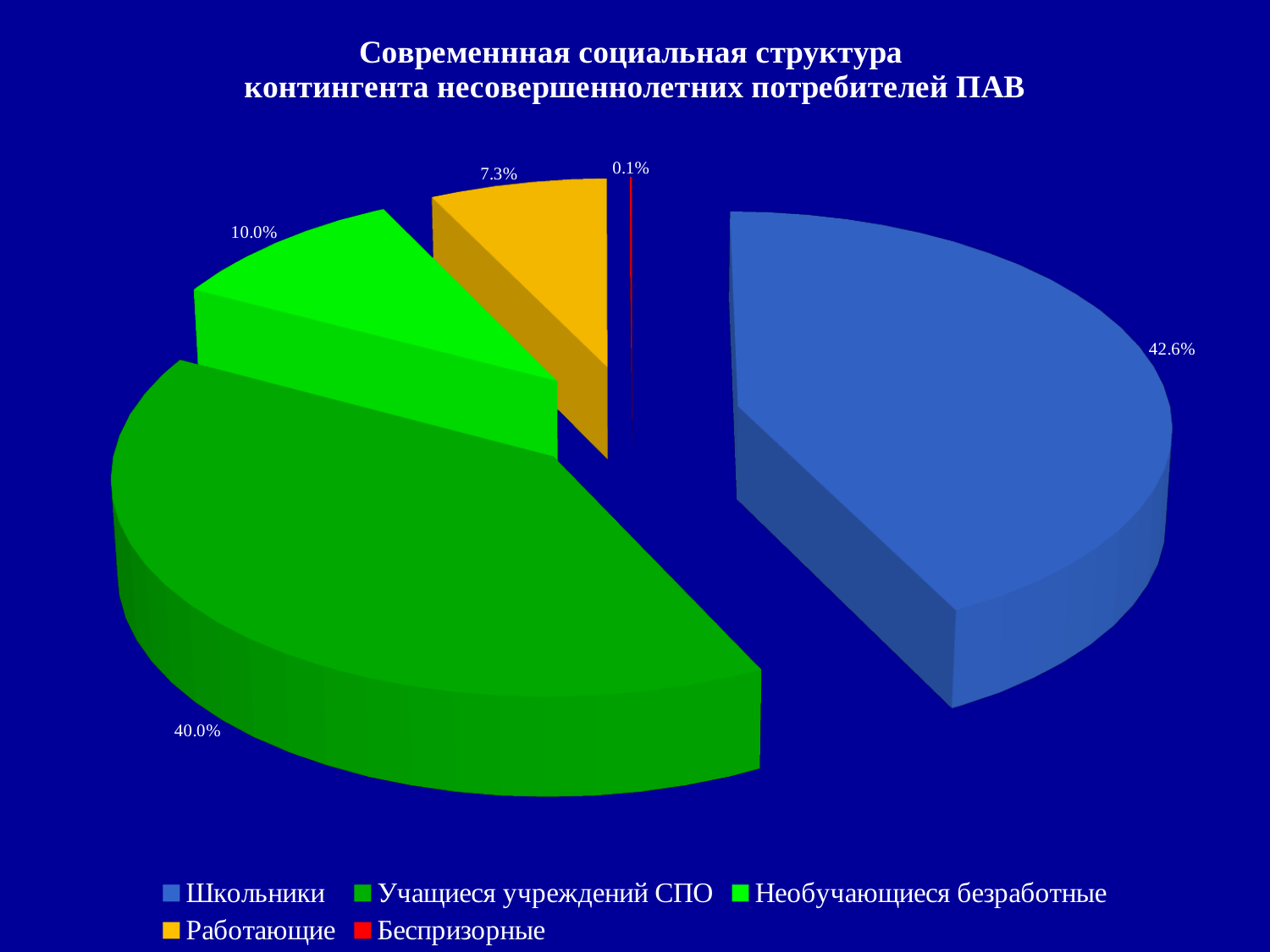
What share of the pie is labelled for Школьники? 42.6% What share of the pie is labelled for Беспризорные? 0.1% What is the difference between the shares of Школьники and Учащиеся учреждений СПО? 2.6% Which category has the smallest share of the pie? Беспризорные What share of the pie is labelled for Необучающиеся безработные? 10.0% What share of the pie is labelled for Учащиеся учреждений СПО? 40.0% What colour is the slice for Работающие? Orange Which category has the largest share of the pie? Школьники What kind of chart is shown on the slide? Pie chart Which is larger: the share of Необучающиеся безработные or the share of Работающие? Необучающиеся безработные What share of the pie is labelled for Работающие? 7.3% How many categories does the legend list? 5